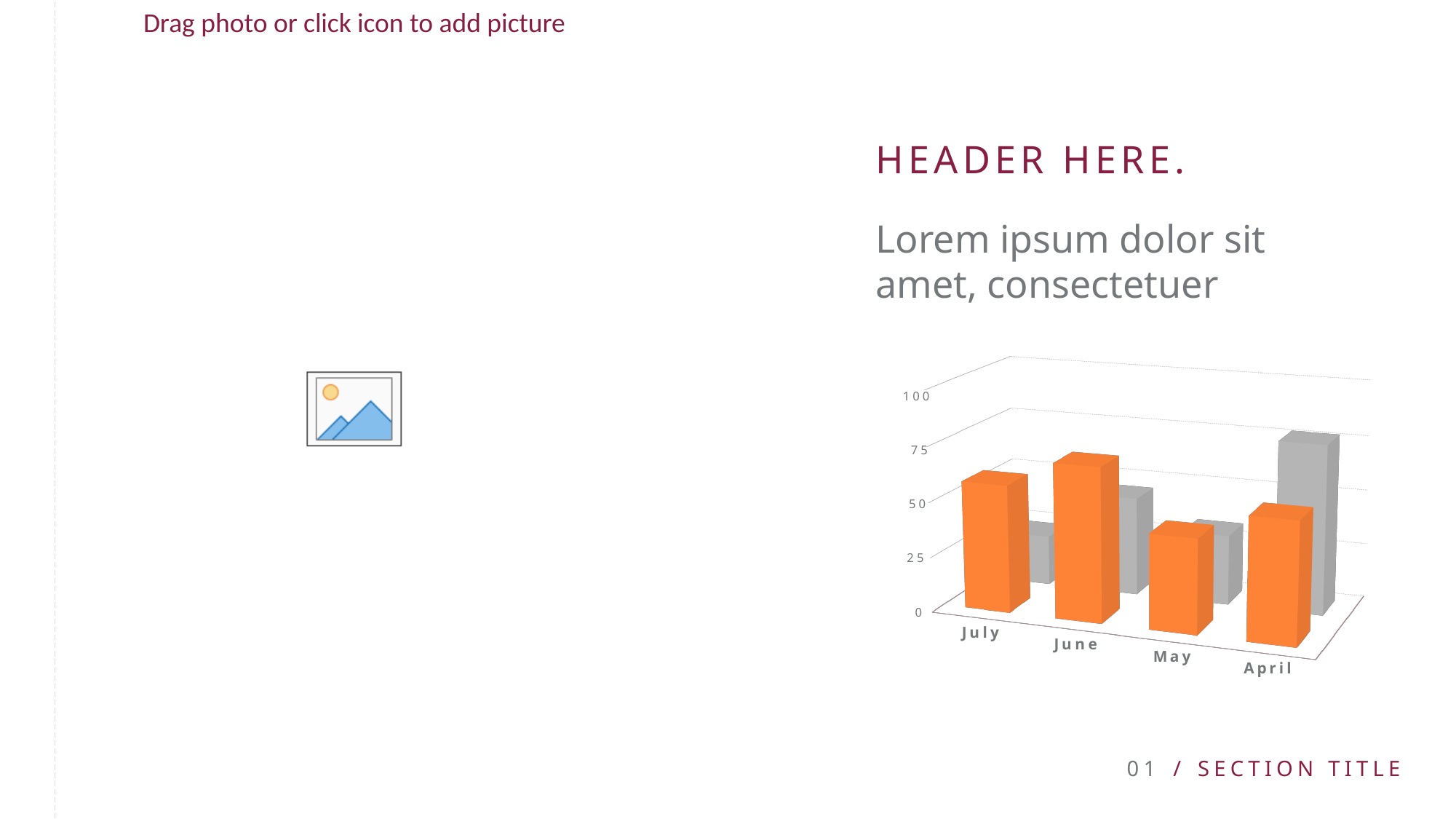
Which is larger, the orange bar for June or the orange bar for May? June Is the gray bar for July greater or less than 50? less What kind of chart is shown on the slide? bar chart What two colours are used for the bars in the chart? orange and gray Is the gray bar for April greater or less than 50? greater Which months are labelled on the x axis of the chart, from left to right? July, June, May, April How many categories are shown on the x axis of the chart? 4 Is the orange bar for June greater or less than 50? greater Which month has the tallest gray bar? April Which month has the tallest orange bar? June Which month has the shortest orange bar? May How many bars are plotted for each month in the chart? 2